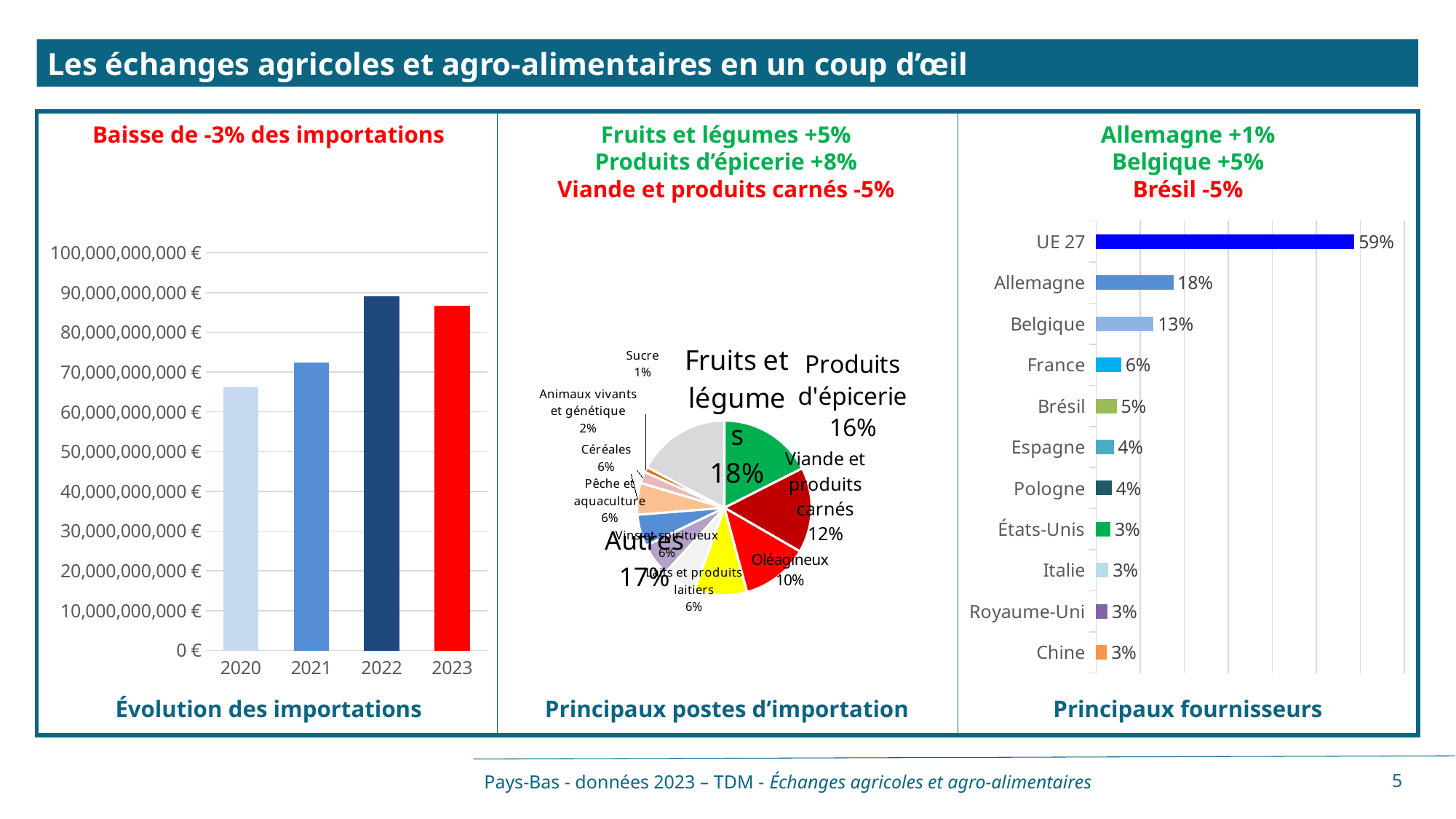
In the 'Évolution des importations' chart, which year has the lowest value? 2020 In the 'Principaux postes d'importation' pie chart, what share does 'Viande et produits carnés' have? 12% In the 'Principaux postes d'importation' pie chart, what share does 'Fruits et légumes' have? 18% In the 'Évolution des importations' chart, do the values rise or fall from 2020 to 2022? rise In the 'Principaux fournisseurs' chart, what is the value for Belgique? 13% In the 'Principaux fournisseurs' chart, how many categories are shown? 11 In the 'Principaux fournisseurs' chart, which category has the highest value? UE 27 In the 'Évolution des importations' chart, which year has the highest value? 2022 In the 'Évolution des importations' chart, what kind of chart is it? bar chart In the 'Évolution des importations' chart, is the value for 2020 greater or less than 70,000,000,000 €? less In the 'Principaux fournisseurs' chart, what is the difference between Allemagne and Belgique? 5% In the 'Évolution des importations' chart, how many years are plotted? 4